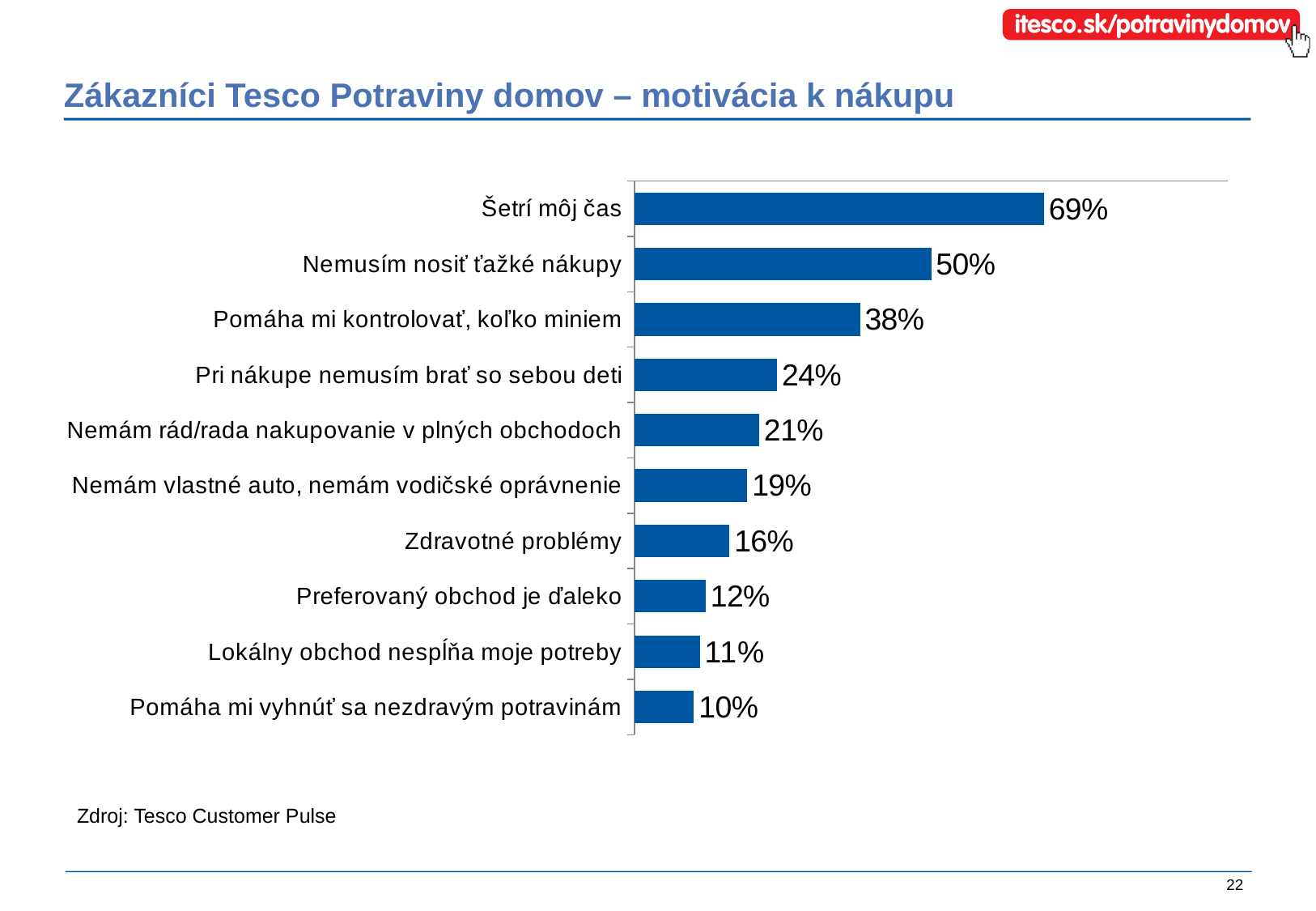
What kind of chart is shown on the slide? Bar chart Which category has the highest value? Šetrí môj čas What is the difference between the values for "Pri nákupe nemusím brať so sebou deti" and "Zdravotné problémy"? 8% What is the value for "Šetrí môj čas"? 69% What source is cited below the chart? Tesco Customer Pulse What is the value for "Lokálny obchod nespĺňa moje potreby"? 11% How many categories are shown in the chart? 10 Which is larger: the value for "Nemám rád/rada nakupovanie v plných obchodoch" or for "Preferovaný obchod je ďaleko"? Nemám rád/rada nakupovanie v plných obchodoch What is the value for "Zdravotné problémy"? 16% What is the value for "Pomáha mi kontrolovať, koľko miniem"? 38% What is the difference between the values for "Šetrí môj čas" and "Nemusím nosiť ťažké nákupy"? 19% Which category has the lowest value? Pomáha mi vyhnúť sa nezdravým potravinám